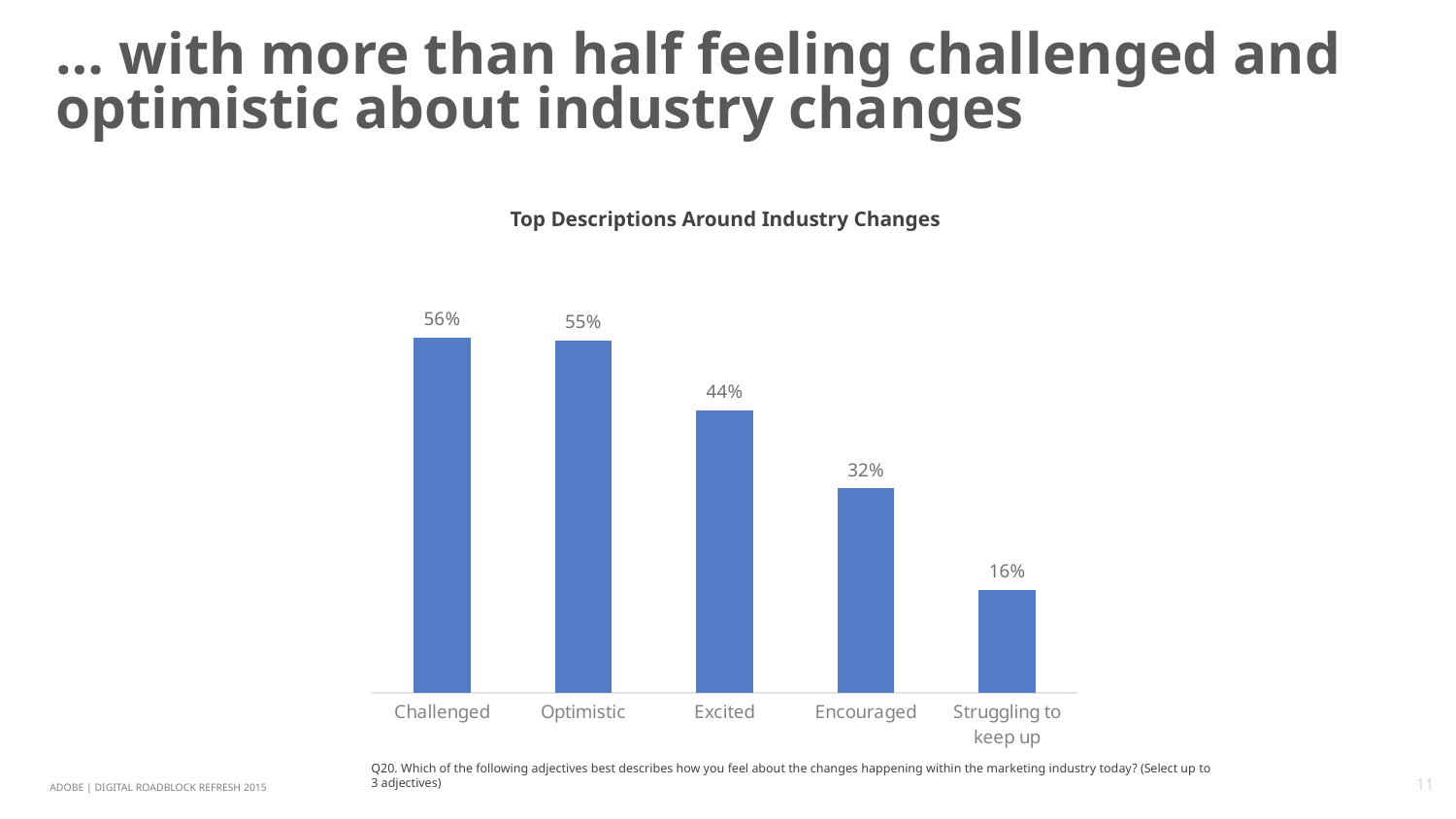
What is the title of the chart? Top Descriptions Around Industry Changes What is the value for Struggling to keep up? 16% How many categories are shown in the chart? 5 Do the values rise or fall from left to right along the x axis? Fall What is the value for Challenged? 56% Which is larger, the value for Optimistic or the value for Encouraged? Optimistic What is the value for Excited? 44% Which category has the highest value? Challenged Which category has the lowest value? Struggling to keep up What is the difference between the values for Challenged and Struggling to keep up? 40% What kind of chart is shown on the slide? Bar chart What is the difference between the values for Excited and Encouraged? 12%